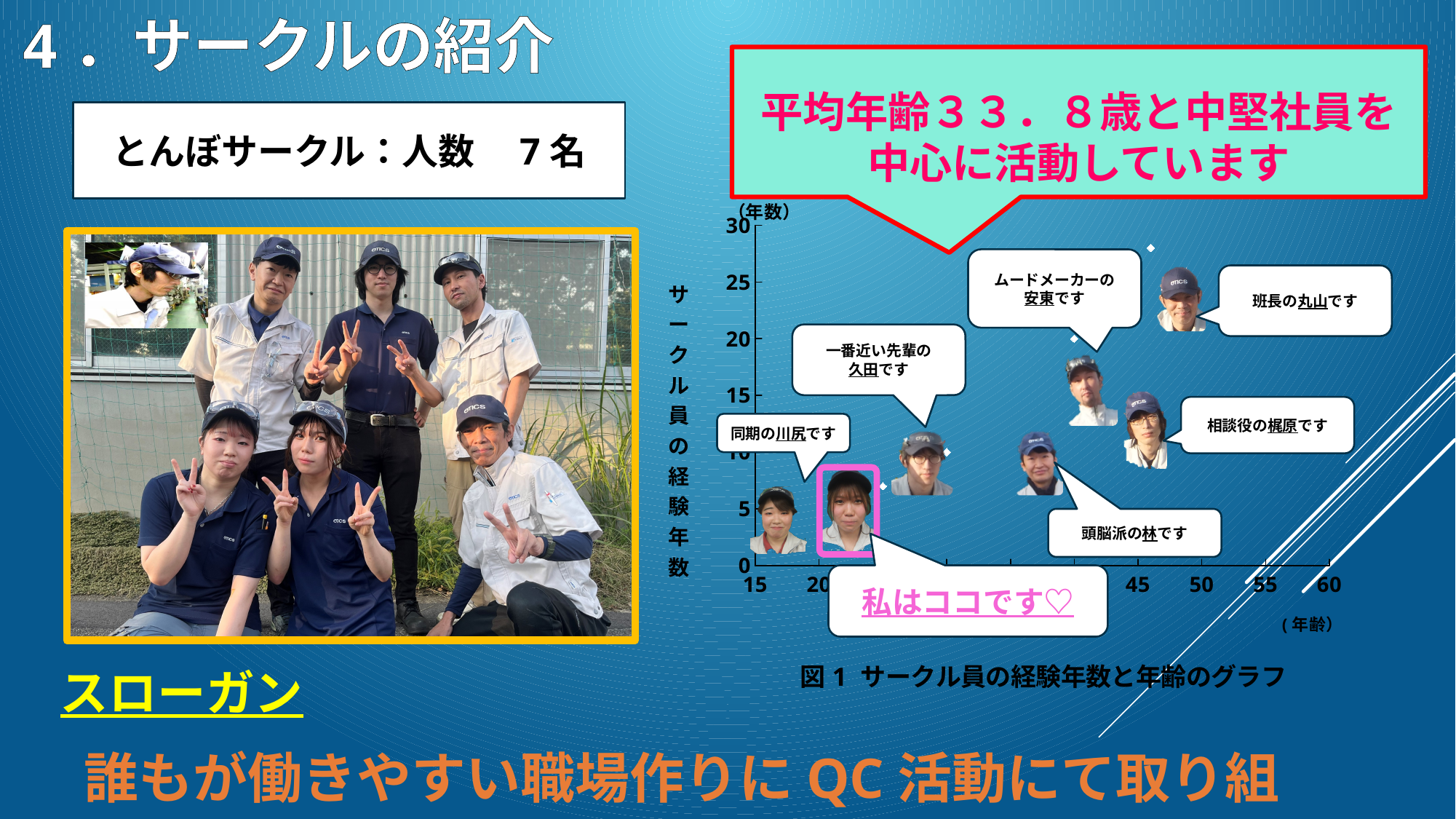
What is the caption/title of the chart on the right of the slide? 図1 サークル員の経験年数と年齢のグラフ How many members (data points) are plotted on the chart? 7 Is the age of 丸山 on the chart greater or less than 40? greater Is the age of 林 on the chart greater or less than 30? greater Is the age of 川尻 on the chart greater or less than 25? less What quantity is plotted on the vertical axis of the chart? サークル員の経験年数 (年数) Who has more years of experience according to the chart, 安東 or 川尻? 安東 Who is older according to the chart, 丸山 or 川尻? 丸山 What kind of chart is 図1 サークル員の経験年数と年齢のグラフ? scatter chart Which member is the youngest (leftmost point) on the chart? 川尻